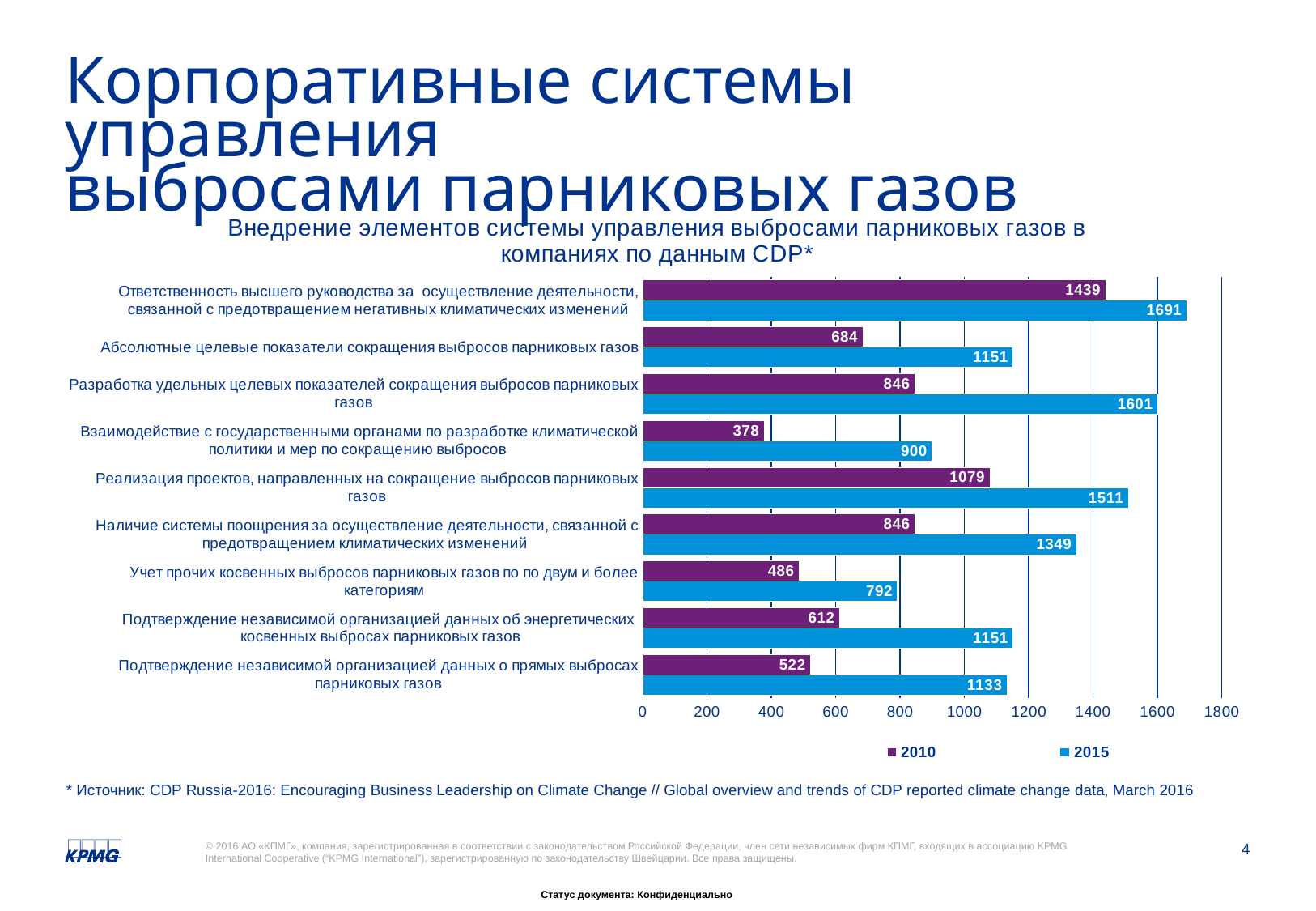
Which years are listed in the chart legend? 2010 and 2015 What is the 2010 value for «Взаимодействие с государственными органами по разработке климатической политики и мер по сокращению выбросов»? 378 How many categories are shown in the chart? 9 What is the 2015 value for «Ответственность высшего руководства за осуществление деятельности, связанной с предотвращением негативных климатических изменений»? 1691 What is the 2015 value for «Разработка удельных целевых показателей сокращения выбросов парниковых газов»? 1601 Is the 2015 value for «Подтверждение независимой организацией данных о прямых выбросах парниковых газов» greater or less than 1000? greater Which is larger: the 2010 value for «Реализация проектов, направленных на сокращение выбросов парниковых газов» or the 2010 value for «Наличие системы поощрения за осуществление деятельности, связанной с предотвращением климатических изменений»? Реализация проектов, направленных на сокращение выбросов парниковых газов Which category has the lowest 2015 value? Учет прочих косвенных выбросов парниковых газов по по двум и более категориям How many series does the legend list? 2 What kind of chart is shown on the slide? Bar chart What is the difference between the 2015 and 2010 values for «Абсолютные целевые показатели сокращения выбросов парниковых газов»? 467 Which category has the highest 2010 value? Ответственность высшего руководства за осуществление деятельности, связанной с предотвращением негативных климатических изменений